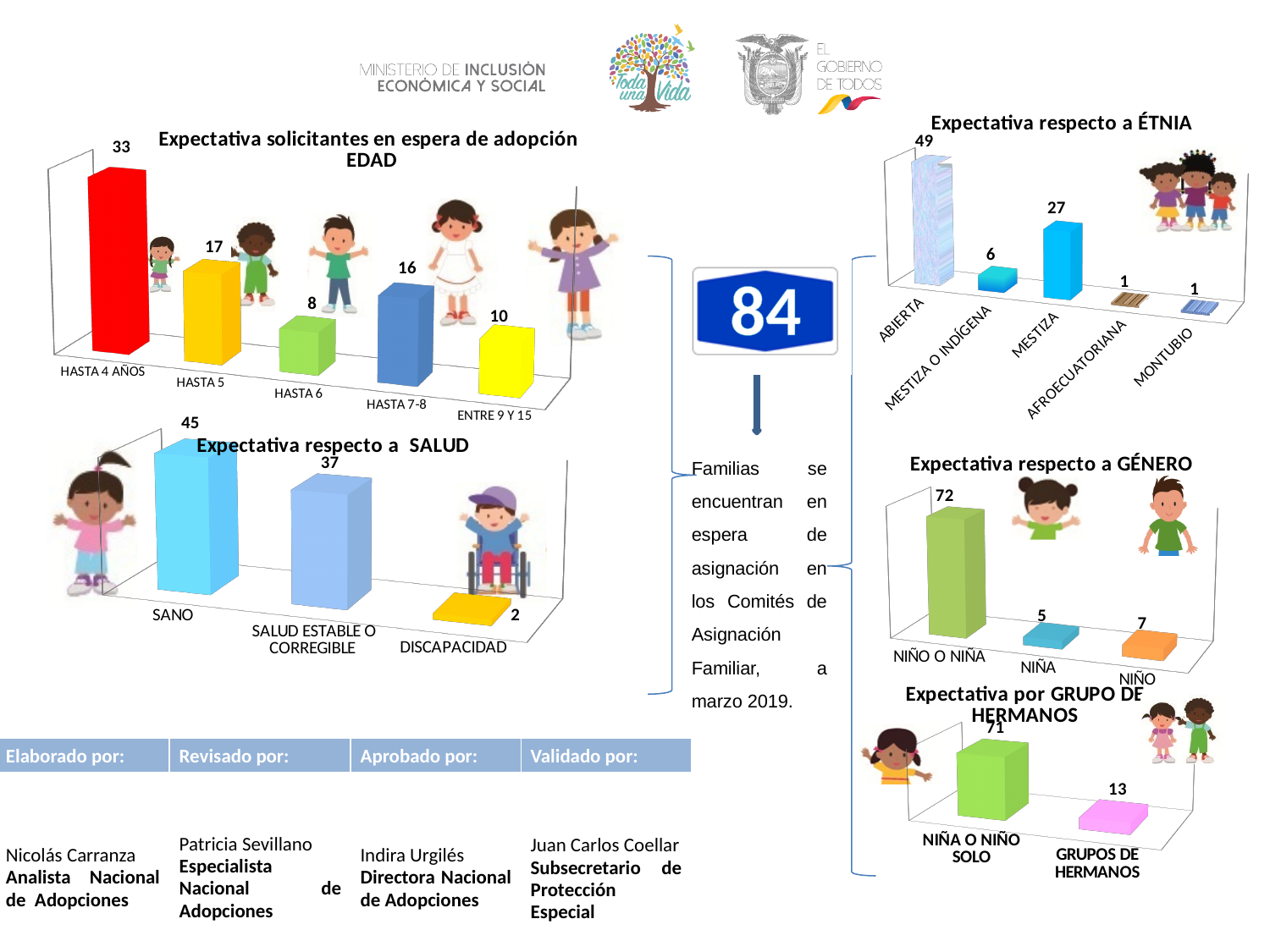
In the 'Expectativa respecto a SALUD' chart, which category has the highest value? SANO In the 'Expectativa respecto a SALUD' chart, what is the value for SALUD ESTABLE O CORREGIBLE? 37 In the 'Expectativa respecto a GÉNERO' chart, what is the value for NIÑO O NIÑA? 72 In the 'Expectativa solicitantes en espera de adopción EDAD' chart, what is the difference between HASTA 5 and HASTA 7-8? 1 How many categories are shown in the 'Expectativa solicitantes en espera de adopción EDAD' chart? 5 In the 'Expectativa respecto a ÉTNIA' chart, which is larger, ABIERTA or MESTIZA O INDÍGENA? ABIERTA In the 'Expectativa respecto a GÉNERO' chart, what is the difference between NIÑO and NIÑA? 2 In the 'Expectativa respecto a ÉTNIA' chart, what is the value for MESTIZA? 27 In the 'Expectativa por GRUPO DE HERMANOS' chart, what is the value for GRUPOS DE HERMANOS? 13 In the 'Expectativa solicitantes en espera de adopción EDAD' chart, what is the value for HASTA 4 AÑOS? 33 What type of chart is the 'Expectativa por GRUPO DE HERMANOS' chart? Bar chart In the 'Expectativa solicitantes en espera de adopción EDAD' chart, which category has the lowest value? HASTA 6